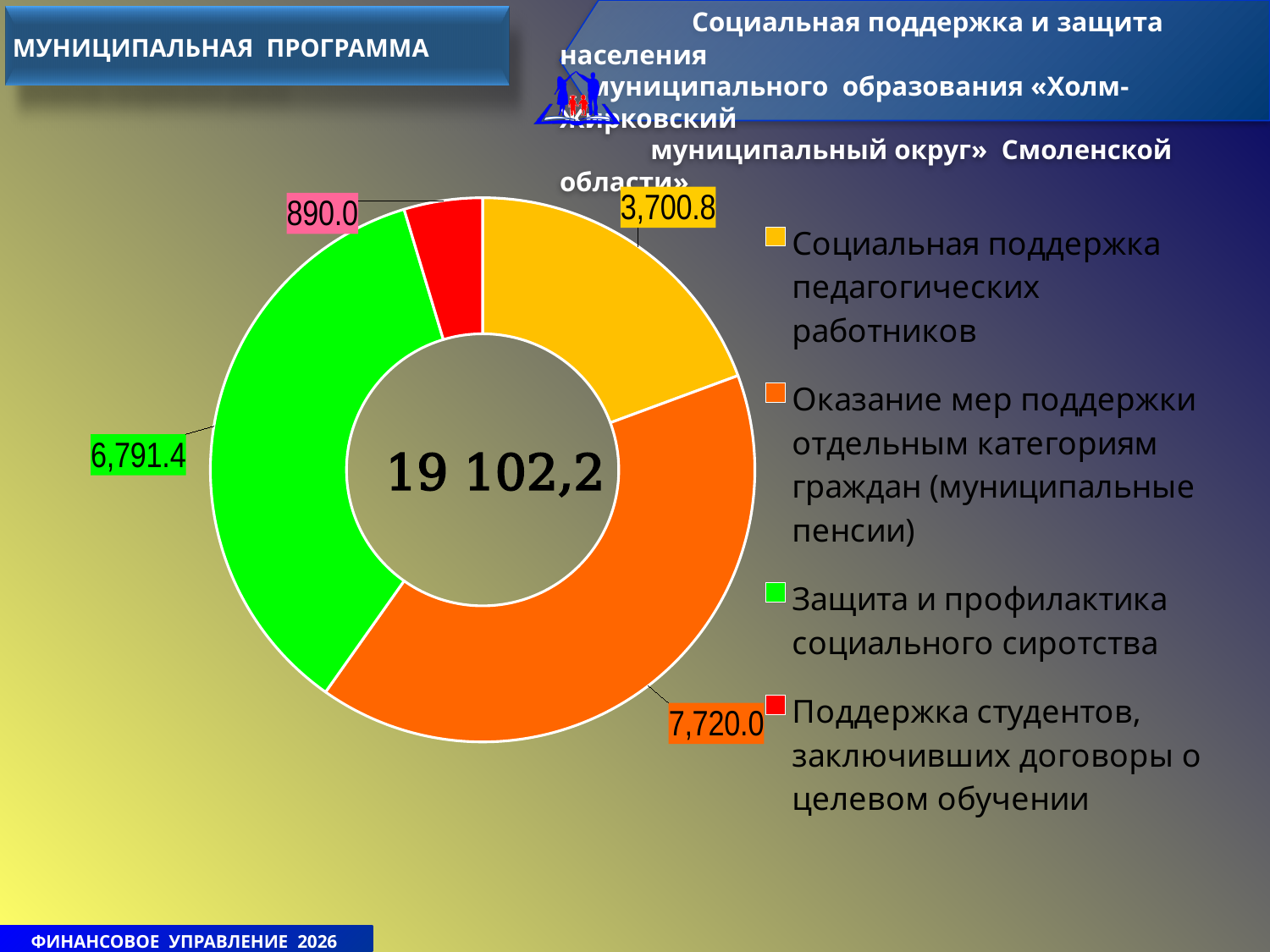
Which category has the largest slice? Оказание мер поддержки отдельным категориям граждан (муниципальные пенсии) Which is larger: «Социальная поддержка педагогических работников» or «Защита и профилактика социального сиротства»? Защита и профилактика социального сиротства What total is printed in the centre of the chart? 19 102,2 What is the value for «Оказание мер поддержки отдельным категориям граждан (муниципальные пенсии)»? 7,720.0 What kind of chart is shown on the slide? Pie (doughnut) chart What is the difference between the values for «Оказание мер поддержки отдельным категориям граждан (муниципальные пенсии)» and «Защита и профилактика социального сиротства»? 928.6 How many categories does the chart show? 4 Which category has the smallest slice? Поддержка студентов, заключивших договоры о целевом обучении What colour is the slice for «Защита и профилактика социального сиротства»? Green What is the value for «Защита и профилактика социального сиротства»? 6,791.4 What is the value for «Социальная поддержка педагогических работников»? 3,700.8 What is the value for «Поддержка студентов, заключивших договоры о целевом обучении»? 890.0